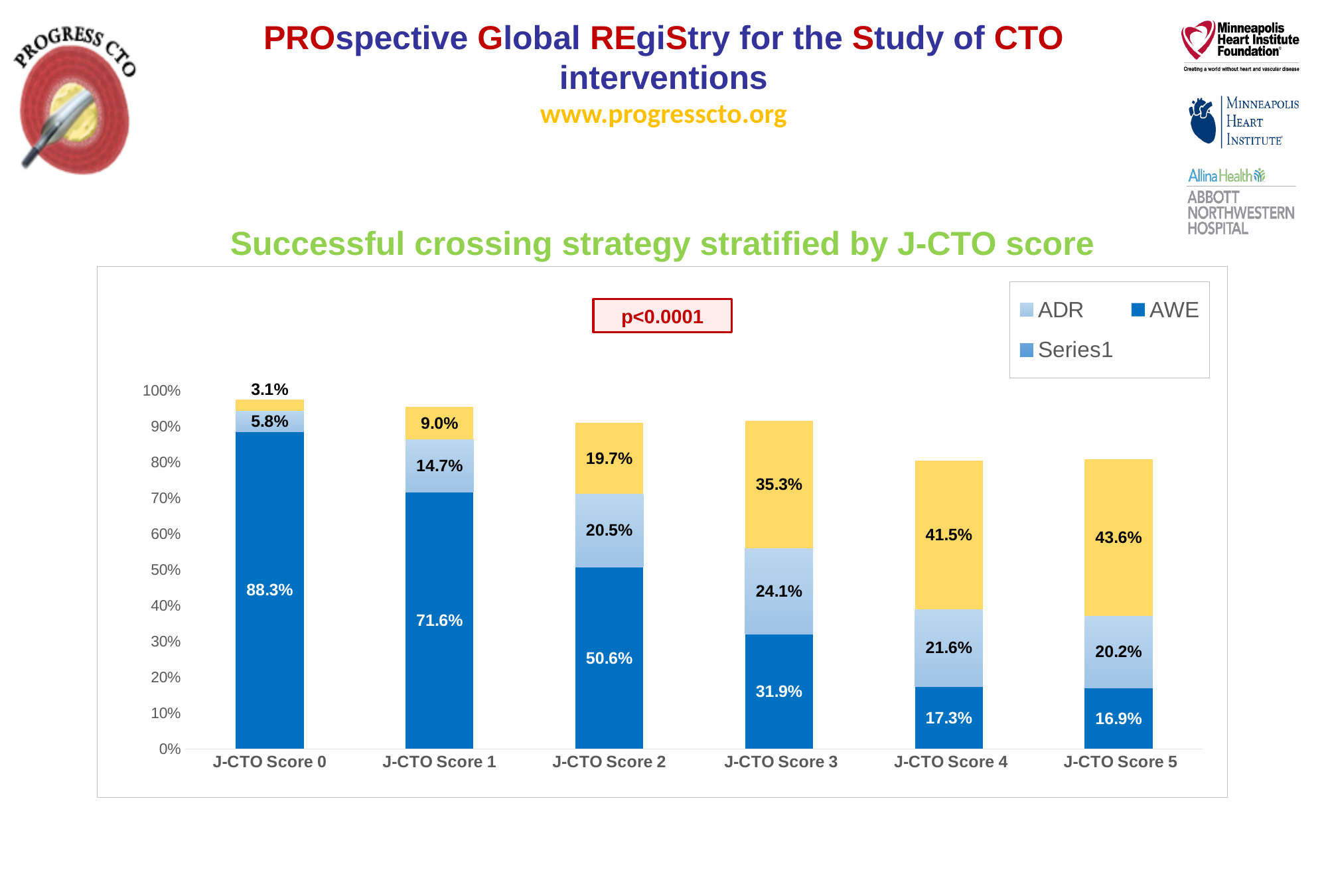
What is the ADR value for J-CTO Score 3? 24.1% Does the AWE value rise or fall as the J-CTO score increases from 0 to 5? Fall What is the value of the yellow top segment for J-CTO Score 5? 43.6% Which is larger, the ADR value for J-CTO Score 4 or the ADR value for J-CTO Score 5? J-CTO Score 4 Which J-CTO score category has the lowest ADR value? J-CTO Score 0 How many J-CTO score categories are shown on the x axis? 6 What is the difference between the AWE values for J-CTO Score 1 and J-CTO Score 2? 21.0% What kind of chart is shown on the slide? Stacked bar chart What is the AWE value for J-CTO Score 0? 88.3% Which J-CTO score category has the highest AWE value? J-CTO Score 0 How many series does the legend list? 3 What is the total of the stacked bar for J-CTO Score 2? 90.8%